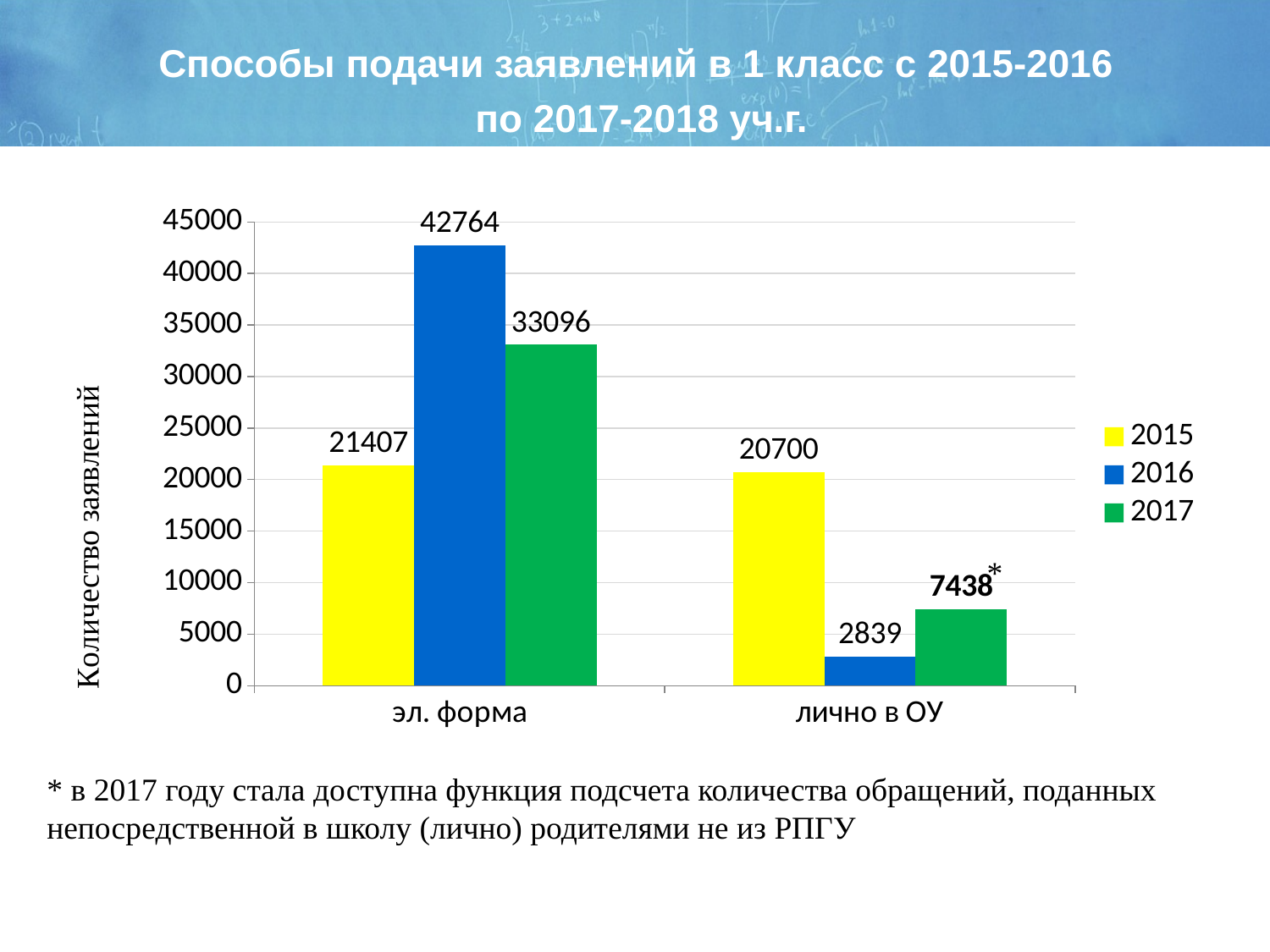
What is the value for 2017 in the 'лично в ОУ' category? 7438 What is the value for 2015 in the 'лично в ОУ' category? 20700 What is the difference between the 2017 and 2016 values in the 'лично в ОУ' category? 4599 What kind of chart is shown on the slide? Bar chart Which year has the highest value in the 'эл. форма' category? 2016 What is the value for 2016 in the 'эл. форма' category? 42764 What is the label of the vertical axis? Количество заявлений Which year has the lowest value in the 'лично в ОУ' category? 2016 How many categories are shown on the x axis? 2 What is the difference between the 2016 and 2015 values in the 'эл. форма' category? 21357 Which is larger: the 2017 value for 'эл. форма' or the 2015 value for 'лично в ОУ'? 2017 value for 'эл. форма' How many series does the legend list? 3